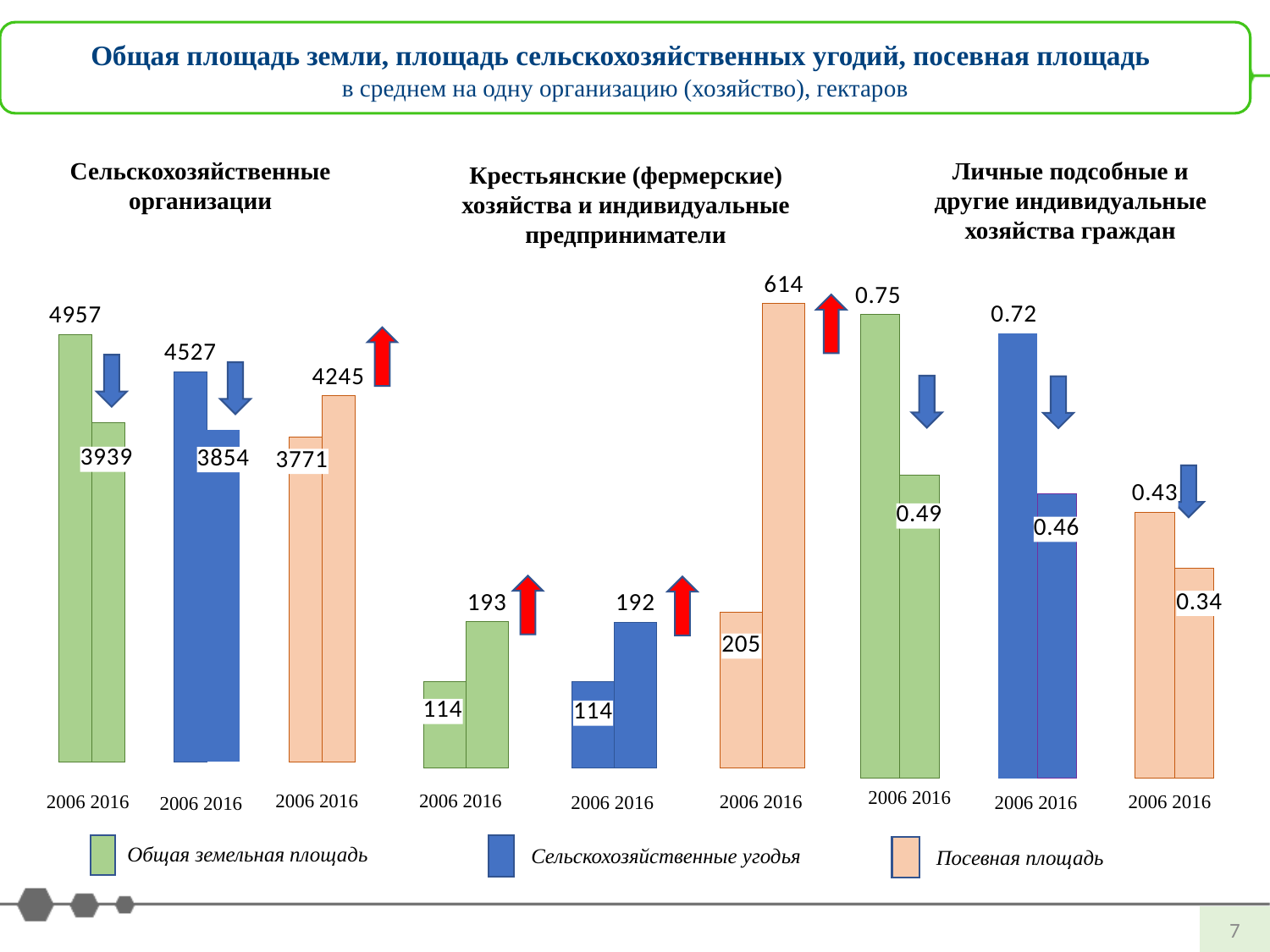
In the 'Личные подсобные и другие индивидуальные хозяйства граждан' chart, which is larger: Общая земельная площадь in 2006 or Сельскохозяйственные угодья in 2006? Общая земельная площадь in 2006 In the 'Крестьянские (фермерские) хозяйства и индивидуальные предприниматели' chart, did Общая земельная площадь rise or fall from 2006 to 2016? rise In the 'Сельскохозяйственные организации' chart, did Посевная площадь rise or fall from 2006 to 2016? rise In the 'Личные подсобные и другие индивидуальные хозяйства граждан' chart, what is the value of Сельскохозяйственные угодья in 2016? 0.46 In the 'Крестьянские (фермерские) хозяйства и индивидуальные предприниматели' chart, what is the difference between Посевная площадь in 2016 and in 2006? 409 In the 'Сельскохозяйственные организации' chart, what is the value of Посевная площадь in 2016? 4245 In the 'Крестьянские (фермерские) хозяйства и индивидуальные предприниматели' chart, what is the value of Посевная площадь in 2016? 614 What kind of chart is used on this slide? bar chart How many series does the legend list? 3 In the 'Сельскохозяйственные организации' chart, which series has the highest value in 2006? Общая земельная площадь In the 'Сельскохозяйственные организации' chart, by how much did Общая земельная площадь decrease from 2006 to 2016? 1018 In the 'Сельскохозяйственные организации' chart, what is the value of Общая земельная площадь in 2006? 4957